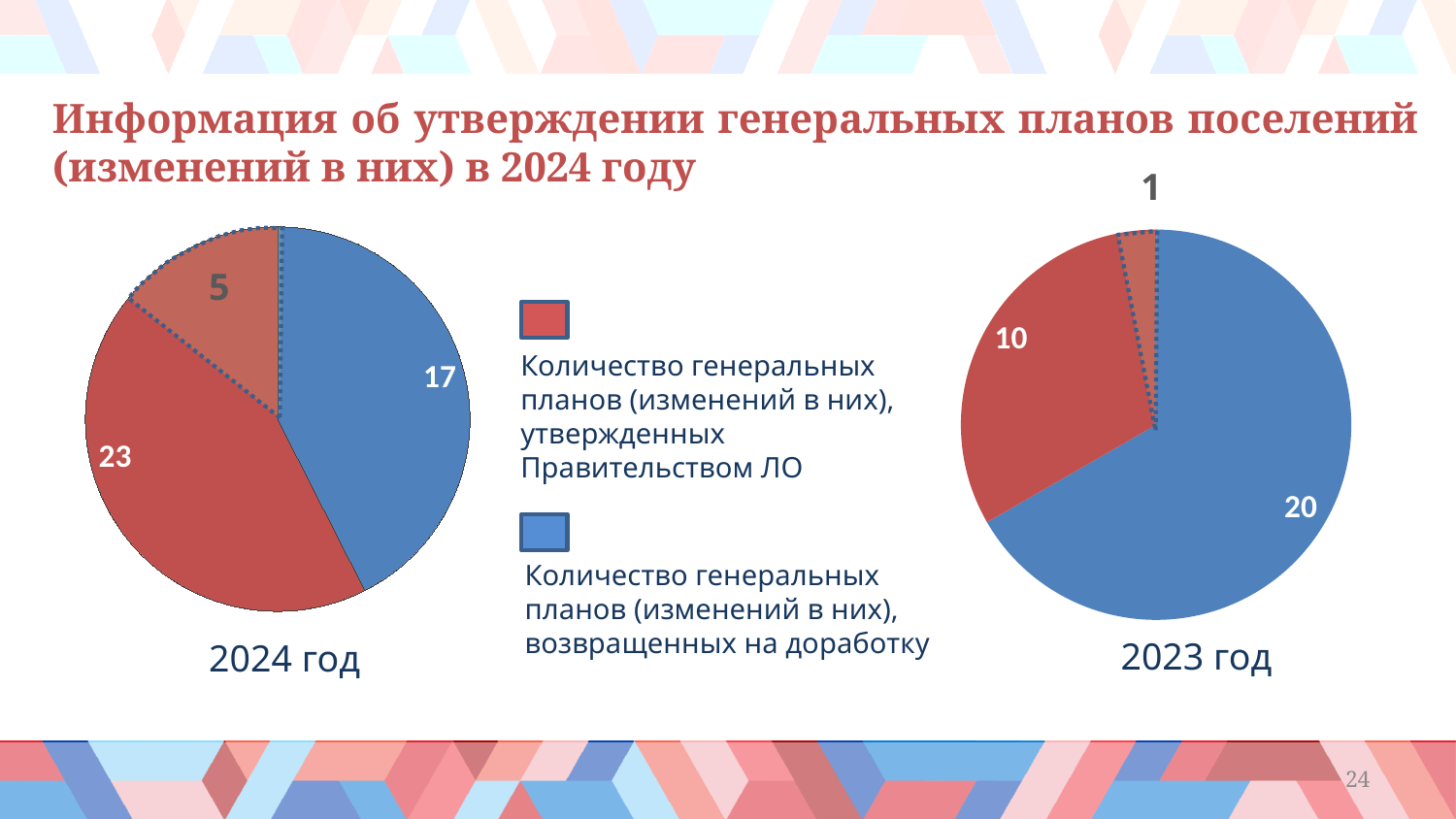
In the 2023 год chart, what is the smallest slice value? 1 In the 2023 год chart, what is the value of the red slice (approved by the Government of LO)? 10 Which year has the larger blue slice (returned for revision): 2024 год with 17 or 2023 год with 20? 2023 год In the 2024 год chart, what is the value of the blue slice (generalnye plany returned for revision)? 17 In the 2023 год chart, what is the difference between the blue slice (20) and the red slice (10)? 10 In the 2024 год chart, which slice has the largest value? 23 How many entries does the legend between the two charts list? 2 In the 2024 год chart, what is the difference between the red slice (23) and the blue slice (17)? 6 In the 2024 год chart, what is the value of the red slice (generalnye plany approved by the Government of LO)? 23 In the 2023 год chart, what is the value of the blue slice (returned for revision)? 20 How many slices does the 2024 год pie chart have? 3 What kind of chart is used for the 2024 год data? pie chart